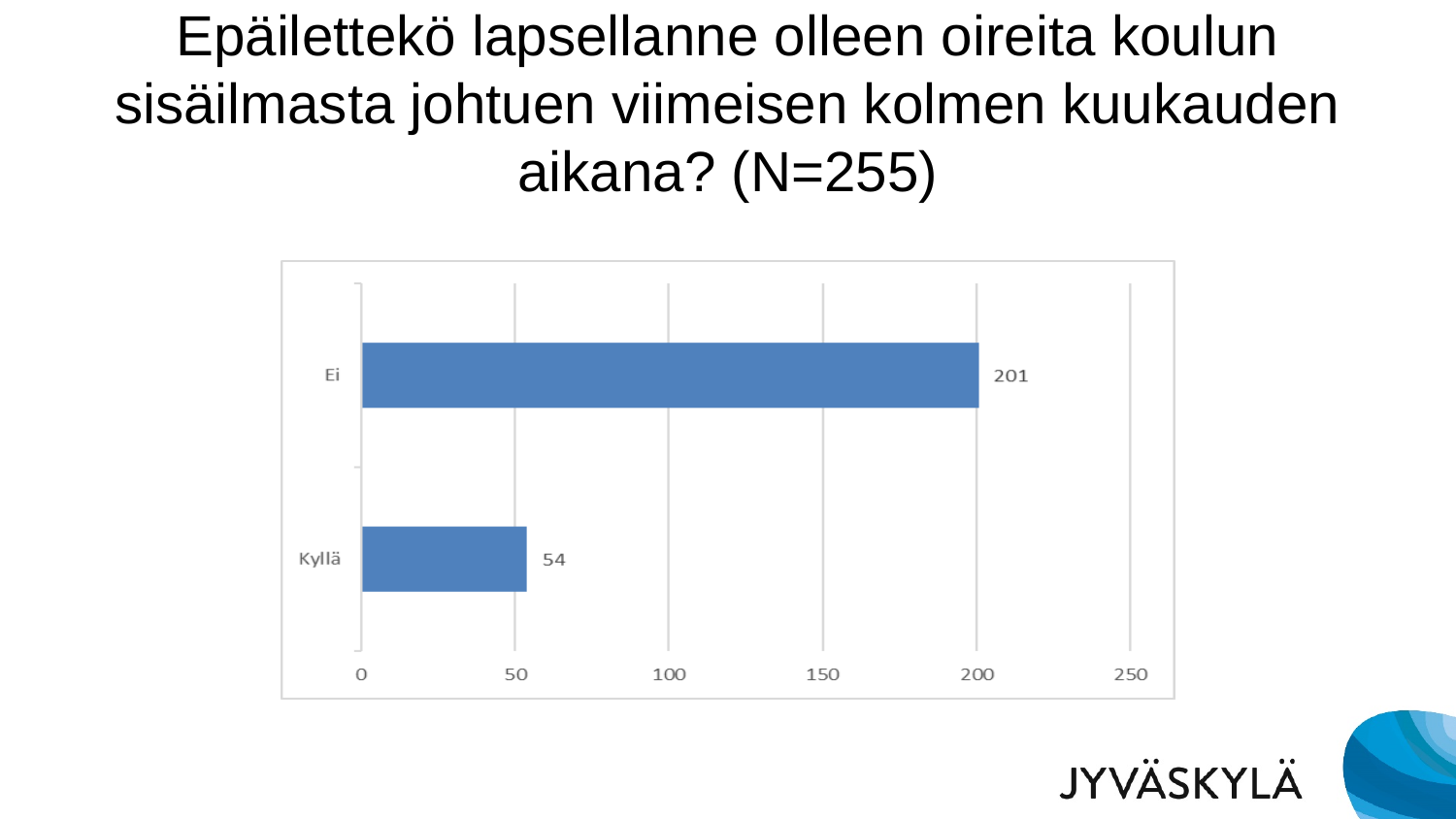
How many categories are shown in the chart? 2 What is the difference between the values for "Ei" and "Kyllä"? 147 Is the value for "Ei" greater or less than 150? greater What kind of chart is shown on the slide? bar chart What is the highest value shown on the x axis? 250 Which is larger, the value for "Ei" or the value for "Kyllä"? Ei Which category has the highest value? Ei What is the value for "Kyllä"? 54 What is the value for "Ei"? 201 What is the total of the two values shown in the chart? 255 Is the value for "Kyllä" greater or less than 100? less Which category has the lowest value? Kyllä